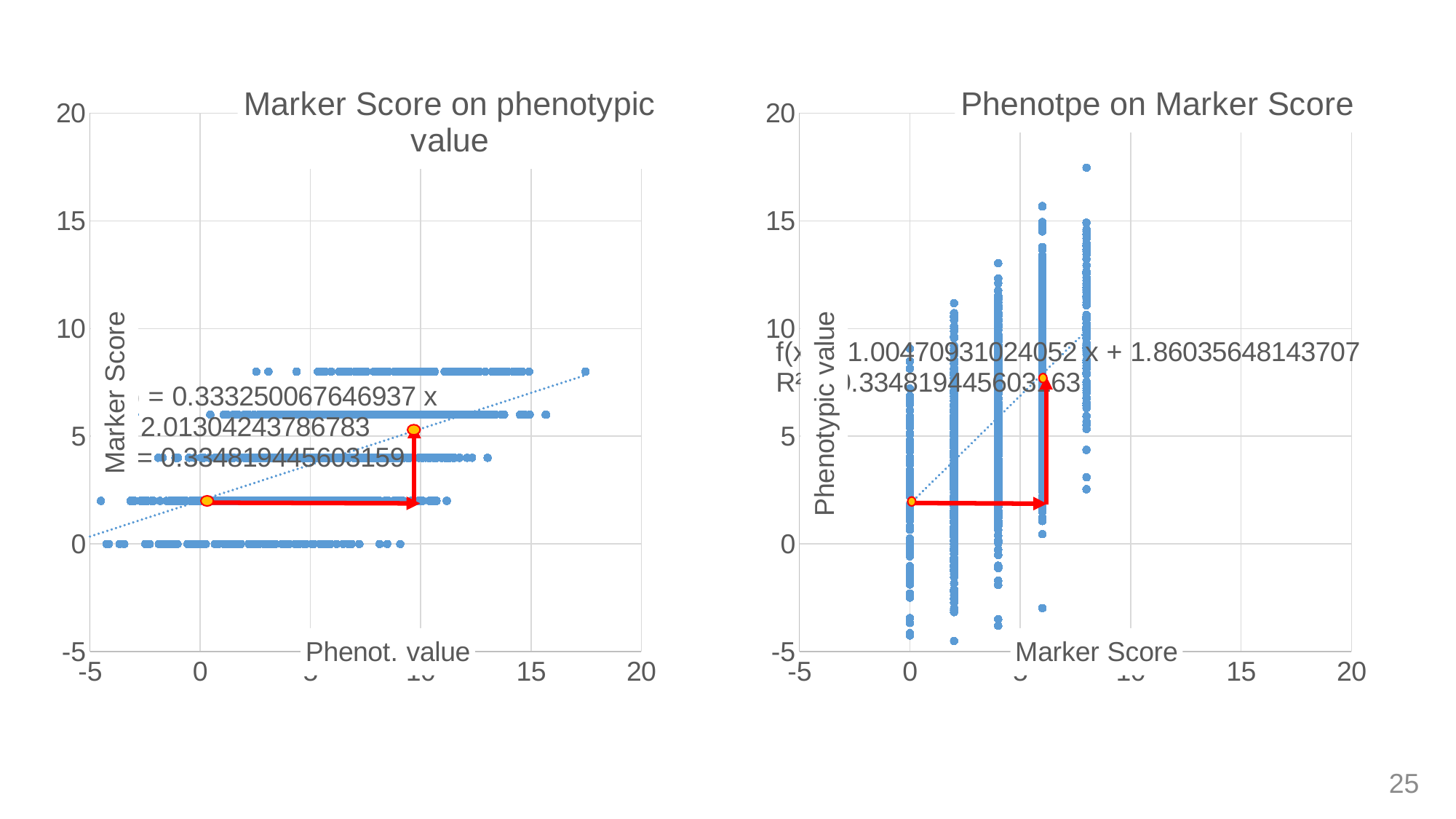
In the left chart "Marker Score on phenotypic value", what slope coefficient is shown in the trend line equation? 0.333250067646937 In the left chart "Marker Score on phenotypic value", what R² value is shown? 0.334819445603159 In the left chart "Marker Score on phenotypic value", what is the highest value shown on the y axis? 20 In the right chart "Phenotpe on Marker Score", what is the intercept of the fitted line f(x) shown in the equation? 1.86035648143707 What is the title of the right chart? Phenotpe on Marker Score In the left chart "Marker Score on phenotypic value", does the dotted trend line rise or fall as phenotypic value increases? Rises In the right chart "Phenotpe on Marker Score", what is the label of the y axis? Phenotypic value In the right chart "Phenotpe on Marker Score", does the dotted trend line rise or fall as Marker Score increases? Rises In the right chart "Phenotpe on Marker Score", is the slope of the fitted line greater or less than 1? greater In the left chart "Marker Score on phenotypic value", is the slope of the trend line greater or less than 0.5? less What kind of chart is the left chart titled "Marker Score on phenotypic value"? Scatter chart In the right chart "Phenotpe on Marker Score", what is the slope of the fitted line f(x) shown in the equation? 1.00470931024052